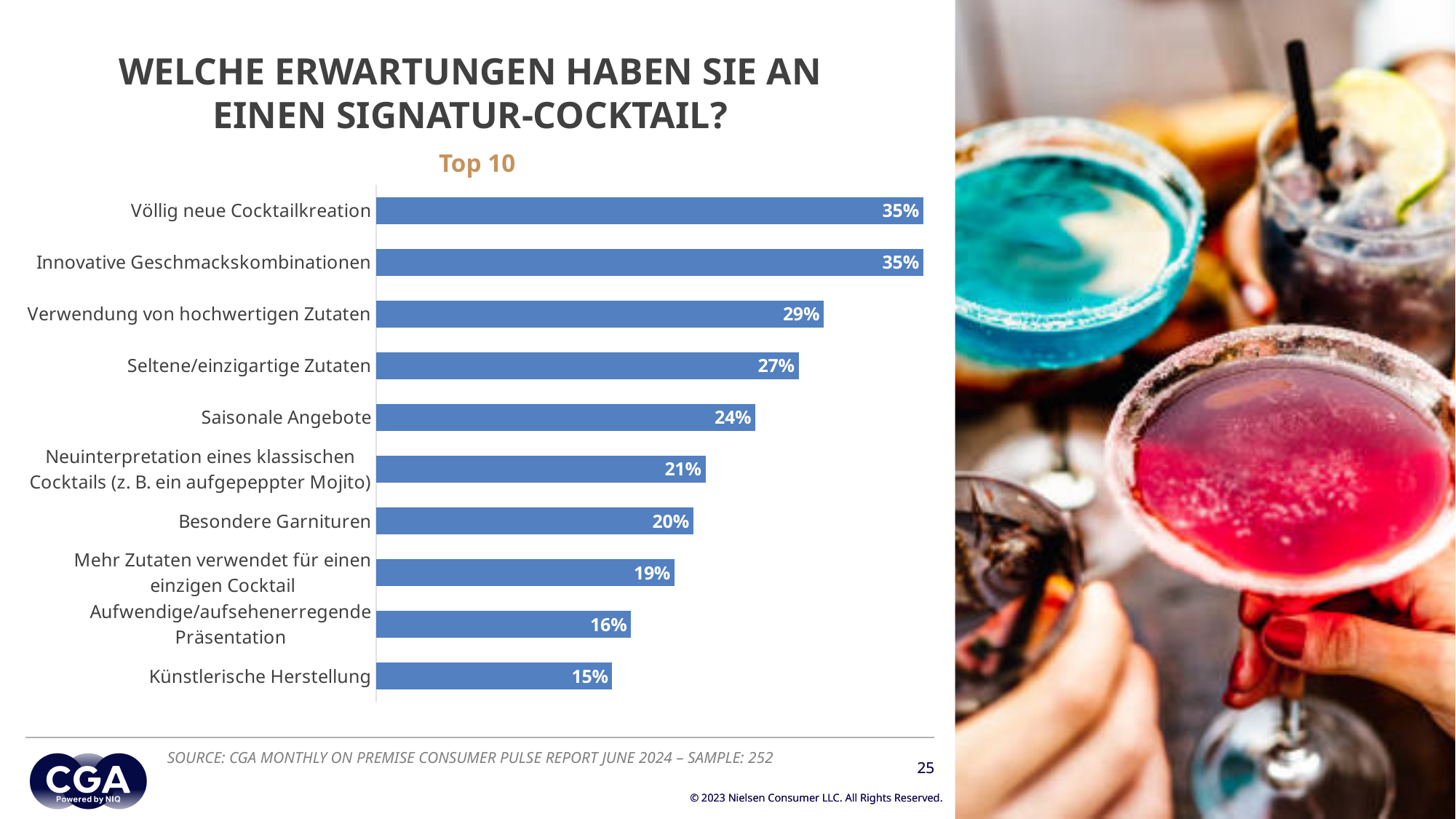
What is the value for Verwendung von hochwertigen Zutaten? 29% What is the value for Saisonale Angebote? 24% What is the difference between Seltene/einzigartige Zutaten and Künstlerische Herstellung? 12% What kind of chart is shown on the slide? Bar chart What is the difference between Völlig neue Cocktailkreation and Saisonale Angebote? 11% What value is shown for Mehr Zutaten verwendet für einen einzigen Cocktail? 19% What is the subtitle shown above the chart? Top 10 Which is larger: Besondere Garnituren or Aufwendige/aufsehenerregende Präsentation? Besondere Garnituren Which is larger: Seltene/einzigartige Zutaten or Neuinterpretation eines klassischen Cocktails (z. B. ein aufgepeppter Mojito)? Seltene/einzigartige Zutaten How many categories are shown in the chart? 10 What is the value for Besondere Garnituren? 20% Which category has the lowest value? Künstlerische Herstellung